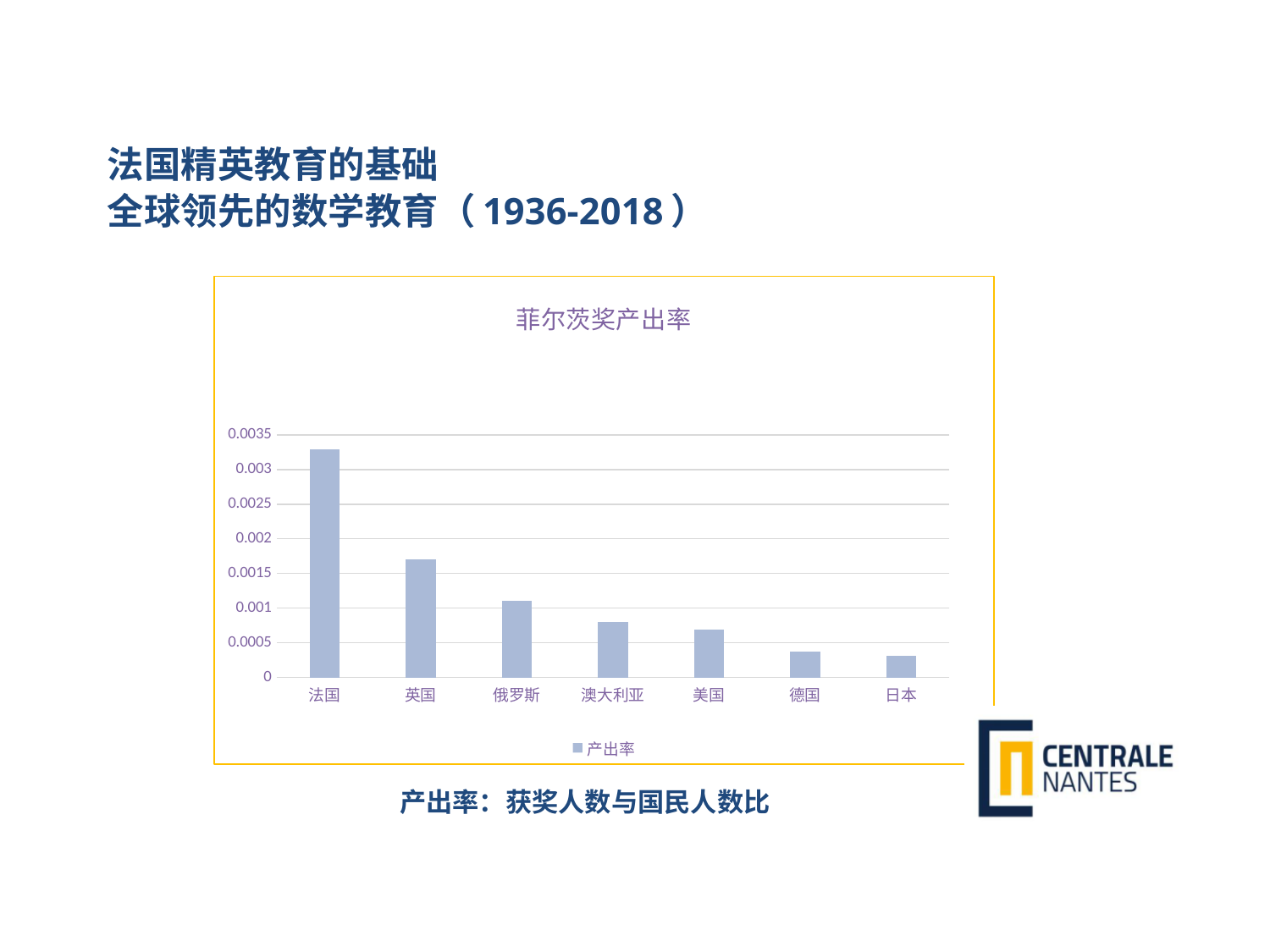
What kind of chart is shown on the slide? bar chart Which country has the highest 产出率 in the chart? 法国 How many countries are shown on the x axis of the chart? 7 Which is larger, the value for 俄罗斯 or the value for 德国? 俄罗斯 Is the value for 法国 greater or less than 0.003? greater Which is larger, the value for 法国 or the value for 英国? 法国 What is the title of the chart? 菲尔茨奖产出率 Is the value for 美国 greater or less than 0.001? less Is the value for 英国 greater or less than 0.0015? greater What is the legend entry of the chart? 产出率 How many series does the chart's legend list? 1 Do the values rise or fall from left to right along the x axis? fall